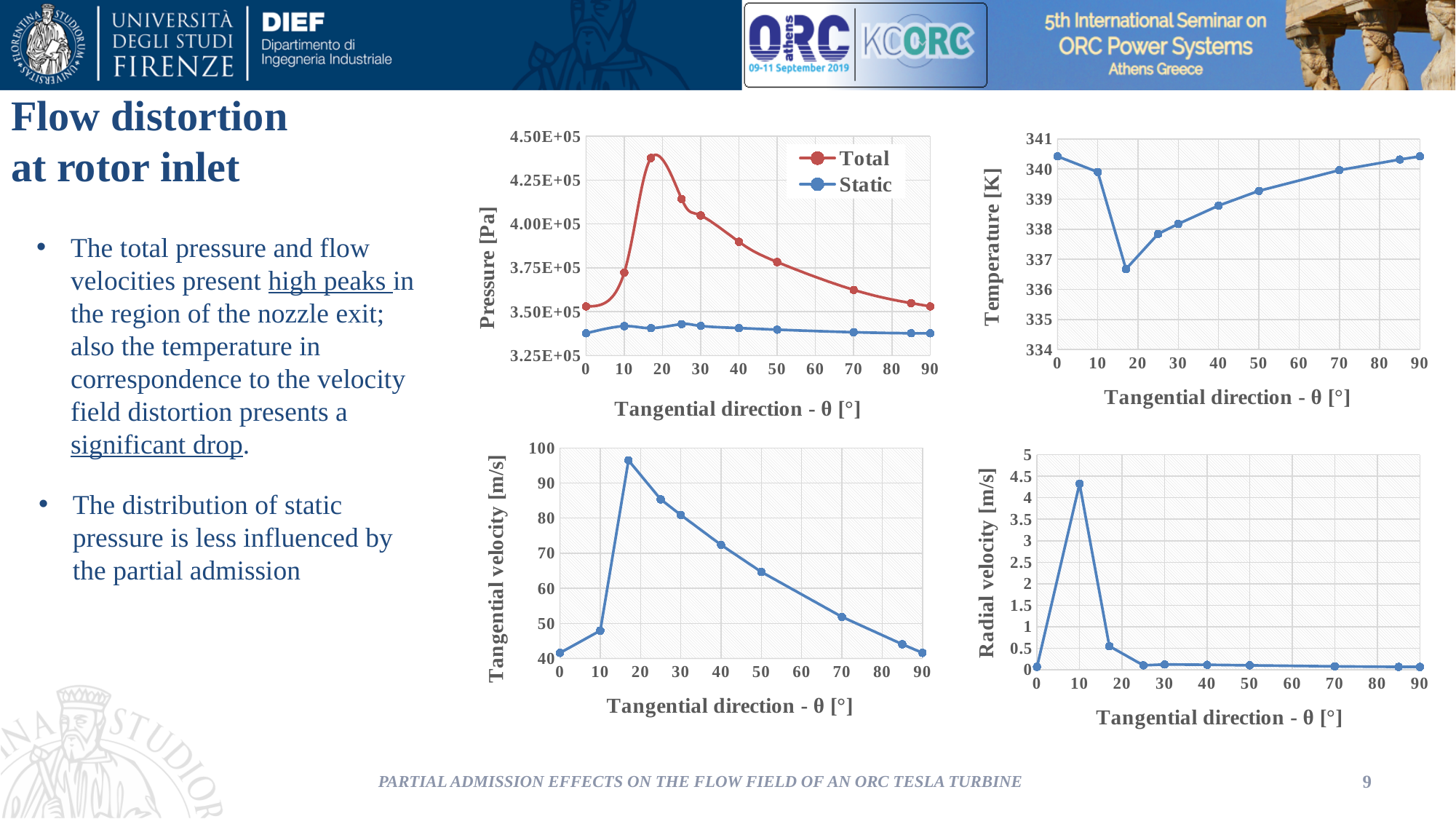
In the top-right temperature chart, is the temperature at a tangential direction of 0° greater or less than 340? greater In the bottom-right radial velocity chart, is the value at a tangential direction of 30° greater or less than 0.5? less What is the y-axis label of the top-right chart? Temperature [K] In the bottom-right radial velocity chart, is the value at a tangential direction of 10° greater or less than 4? greater How many series does the legend of the top-left pressure chart list? 2 In the bottom-left tangential velocity chart, does the velocity rise or fall as the tangential direction goes from 20° to 90°? fall In the top-right temperature chart, does the temperature rise or fall as the tangential direction goes from 20° to 90°? rise What kind of chart is the top-left chart showing pressure against tangential direction? line chart In the top-left pressure chart, which series is larger at a tangential direction of 30°, Total or Static? Total